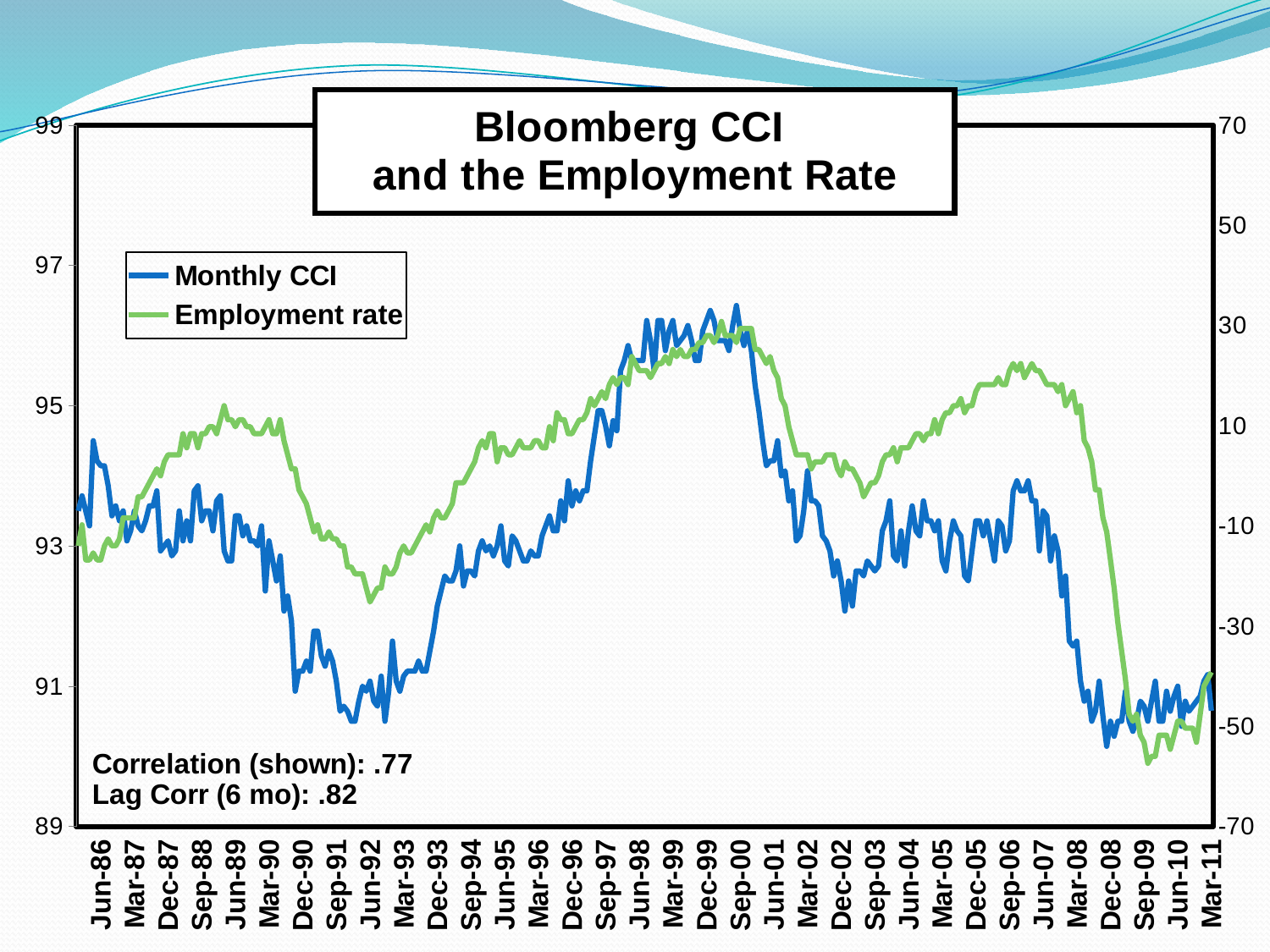
What correlation value is shown on the chart for the two series? .77 What kind of chart is shown on the slide? line chart Does the Employment rate series rise or fall between Jun-92 and Dec-99? rise What is the last date label on the x axis? Mar-11 Does the Employment rate series rise or fall between Mar-08 and Dec-08? fall Does the Monthly CCI series rise or fall between Sep-00 and Dec-02? fall What is the title of the chart? Bloomberg CCI and the Employment Rate What is the 6-month lag correlation stated on the chart? .82 What is the first date label on the x axis? Jun-86 Which colour is used for the Monthly CCI series? blue How many series does the legend list? 2